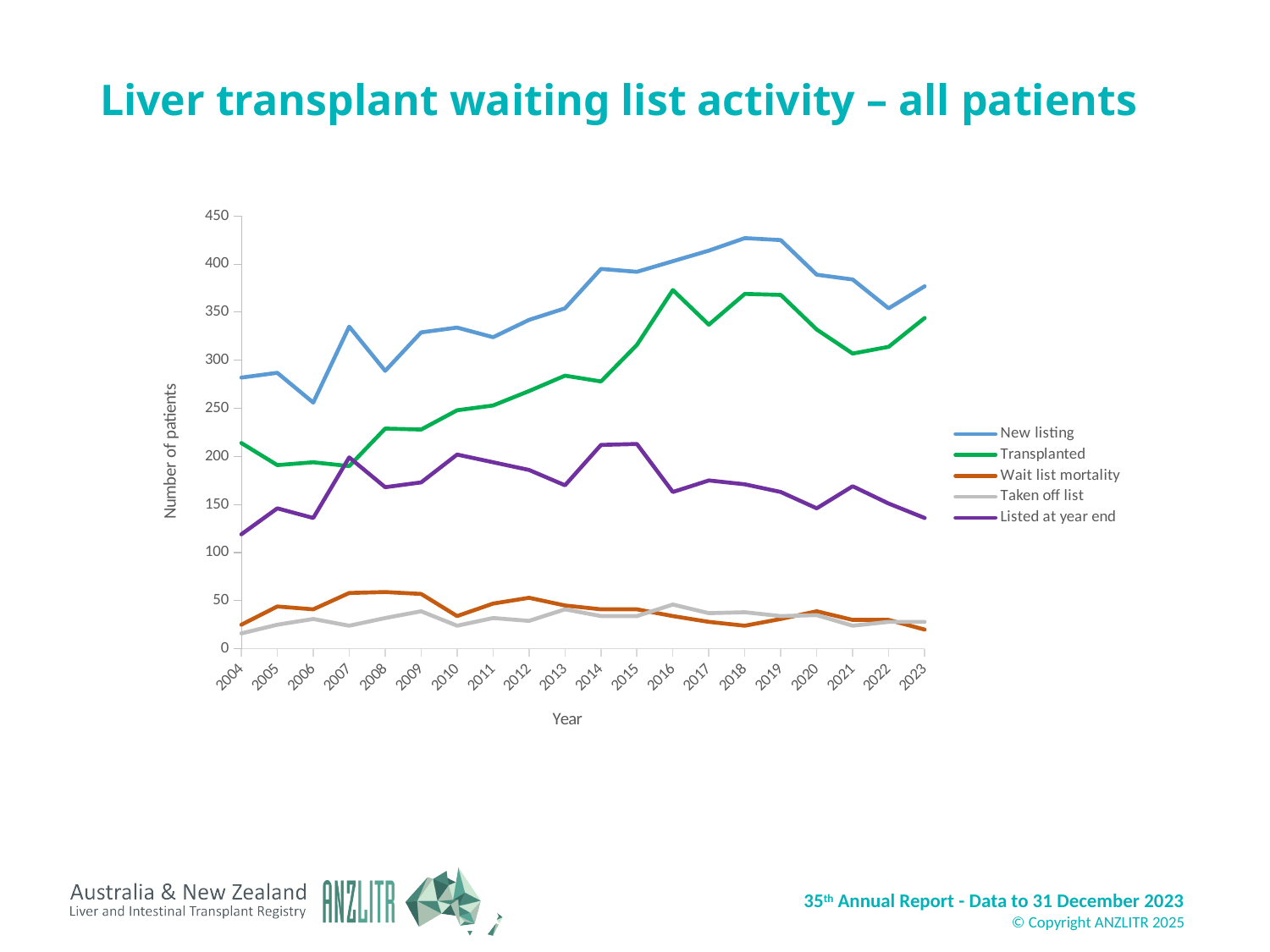
How many years are plotted along the x axis? 20 Did the Transplanted series generally rise or fall from 2004 to 2023? rise Is the value for Transplanted in 2004 greater or less than 200? greater Is the value for New listing in 2018 greater or less than 400? greater Is the value for Listed at year end in 2023 greater or less than 150? less In 2016, which was higher: New listing or Transplanted? New listing What kind of chart is shown on the slide? Line chart In which year was New listing at its lowest? 2006 How many series does the legend list? 5 In which year was Listed at year end at its lowest? 2004 What is the label on the y axis? Number of patients